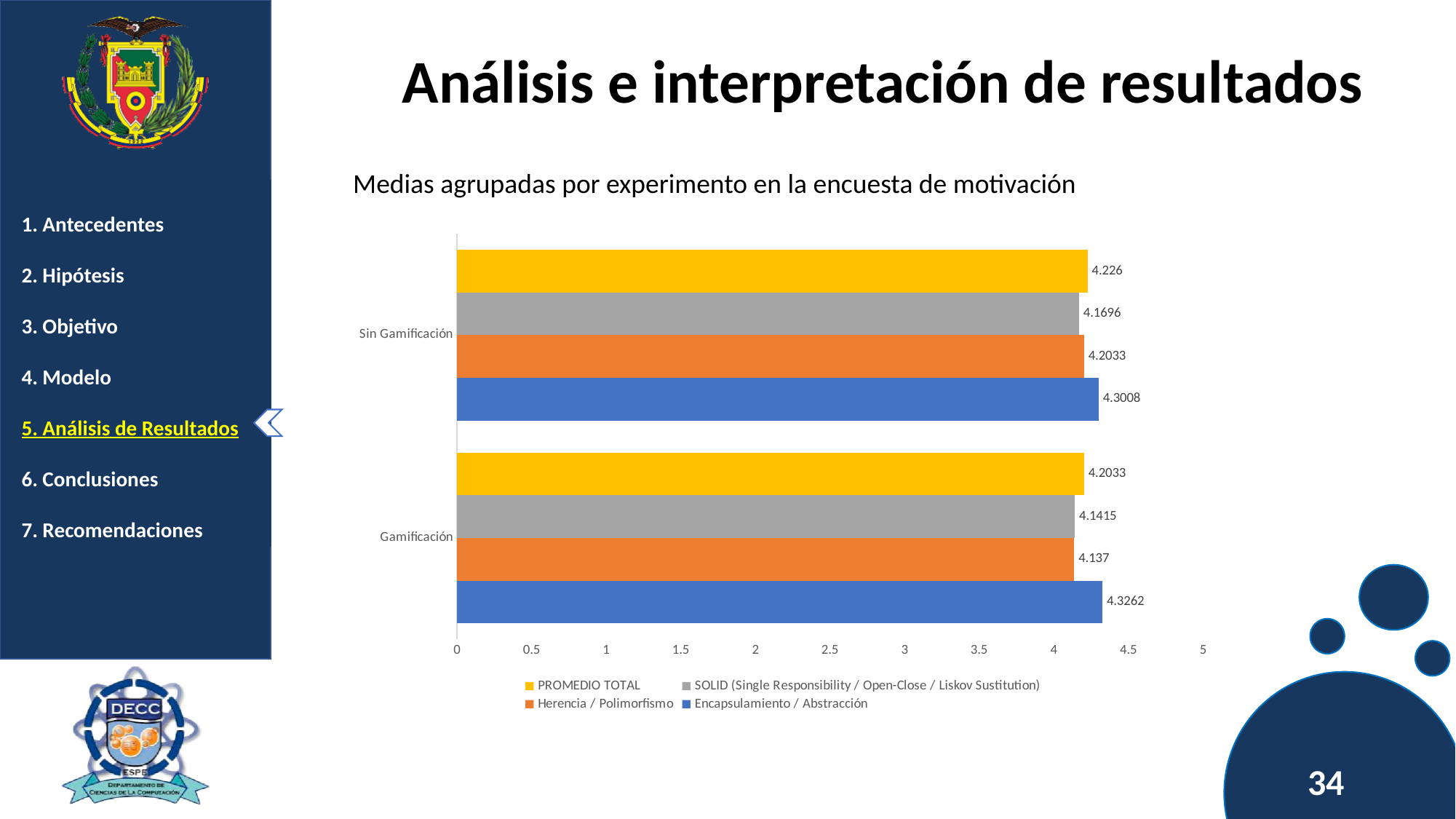
What is the value of Encapsulamiento / Abstracción for Gamificación? 4.3262 What is the value of Herencia / Polimorfismo for Gamificación? 4.137 How many categories are shown on the vertical axis? 2 Which is larger: Herencia / Polimorfismo for Sin Gamificación or for Gamificación? Sin Gamificación Which series has the lowest value for Sin Gamificación? SOLID (Single Responsibility / Open-Close / Liskov Sustitution) What is the difference between the PROMEDIO TOTAL values for Sin Gamificación and Gamificación? 0.0227 What is the value of SOLID (Single Responsibility / Open-Close / Liskov Sustitution) for Sin Gamificación? 4.1696 What is the difference between the Encapsulamiento / Abstracción values for Gamificación and Sin Gamificación? 0.0254 What is the PROMEDIO TOTAL value for Sin Gamificación? 4.226 Which series has the highest value for Gamificación? Encapsulamiento / Abstracción How many series does the legend list? 4 What type of chart is shown on the slide? Bar chart